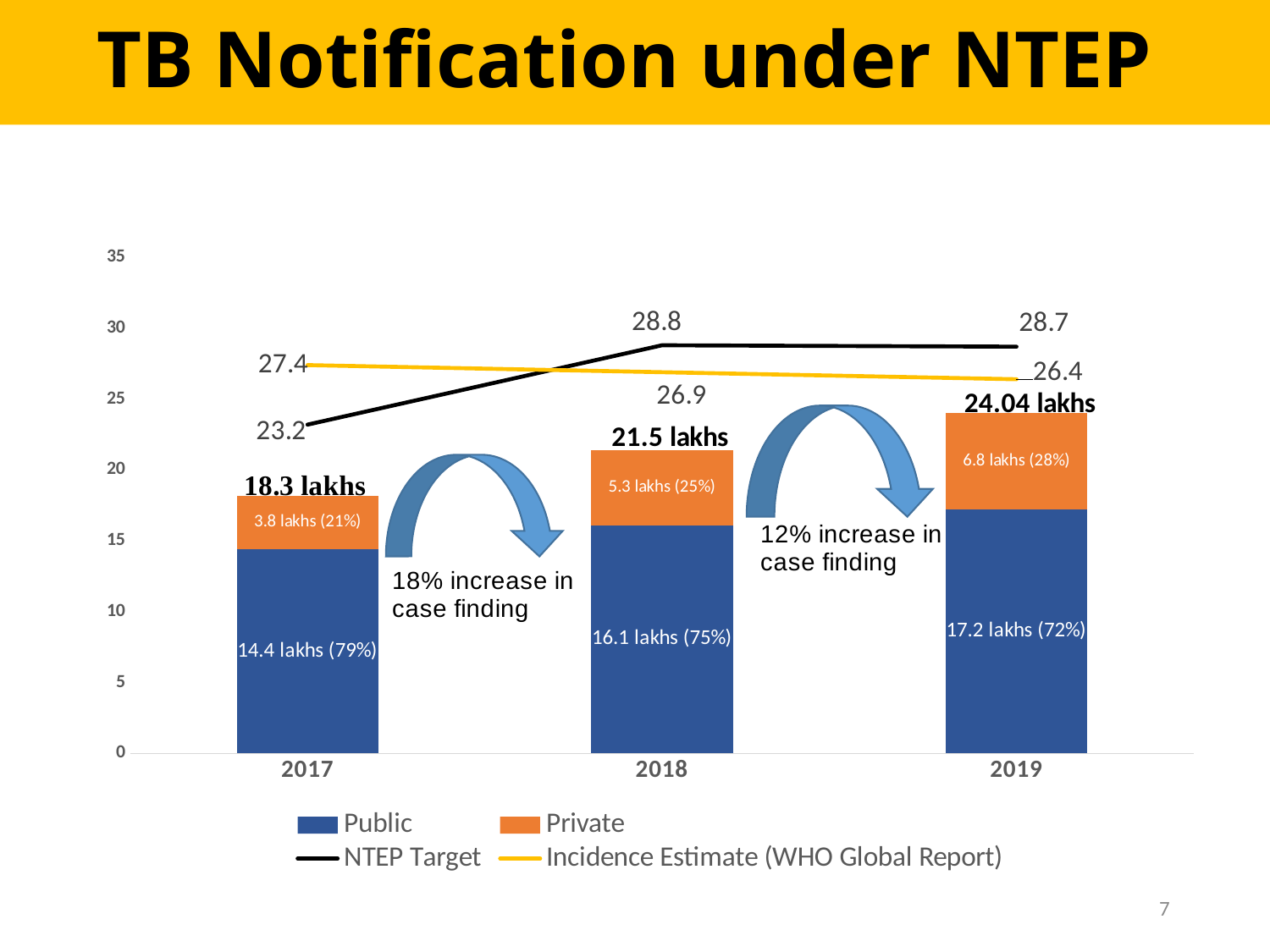
What is the Private value for 2019? 6.8 lakhs (28%) What is the difference between the Public value in 2019 and the Public value in 2017? 2.8 lakhs How many series does the legend list? 4 What is the Incidence Estimate (WHO Global Report) value for 2019? 26.4 Does the Incidence Estimate (WHO Global Report) line rise or fall from 2017 to 2019? fall Which year has the highest Private value? 2019 What kind of chart is shown on the slide? Stacked bar chart with line series Which is larger, the NTEP Target for 2018 or the Incidence Estimate for 2018? NTEP Target for 2018 What is the Public value for 2018? 16.1 lakhs (75%) Which year has the lowest NTEP Target value? 2017 What is the NTEP Target value for 2017? 23.2 What is the total notification for the 2018 stacked bar? 21.5 lakhs